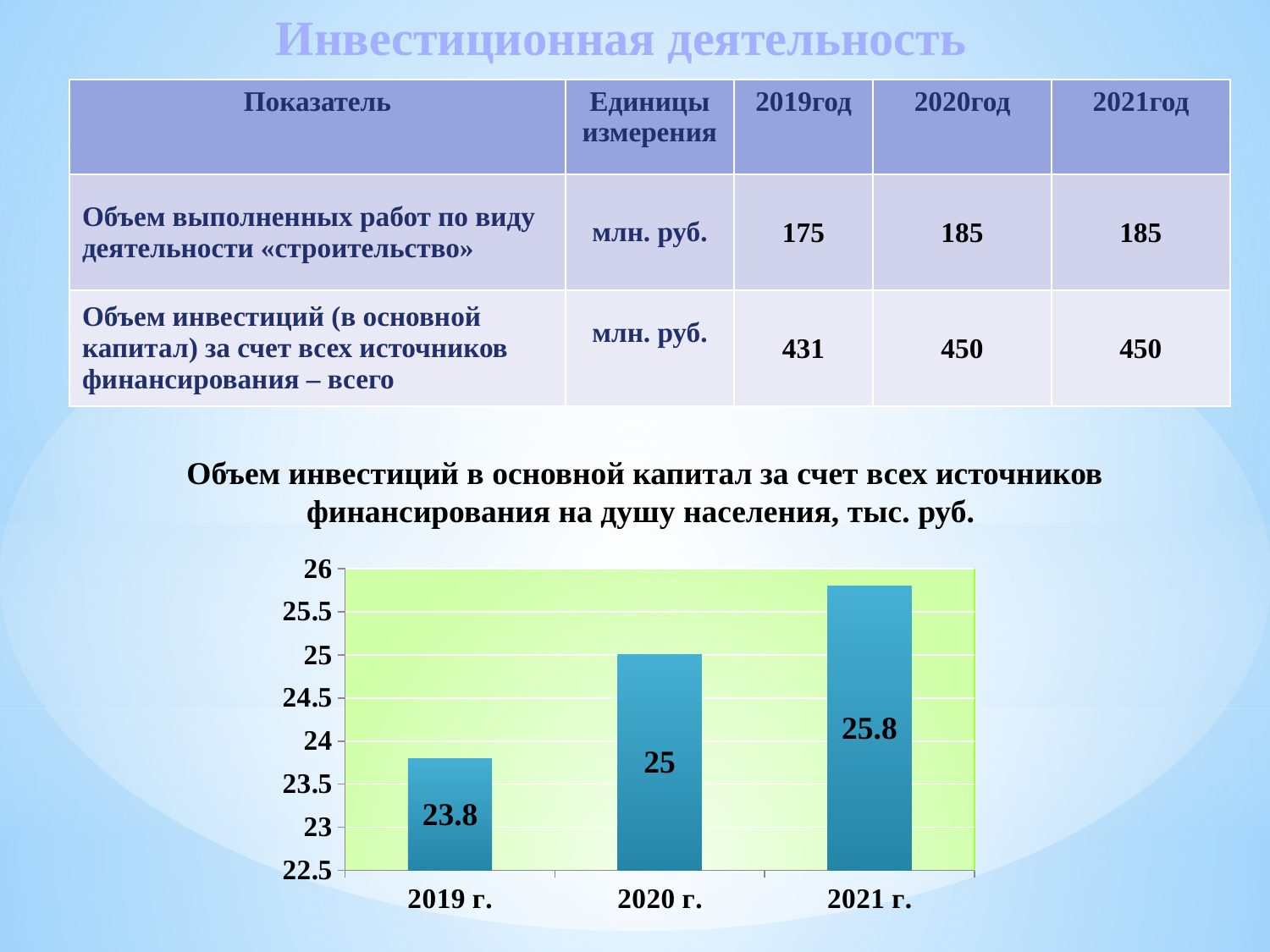
What is the value for 2020 г. in the chart? 25 Which is larger, the value for 2020 г. or the value for 2021 г.? 2021 г. What is the value for 2021 г. in the chart? 25.8 Is the value for 2019 г. greater or less than 24? less Do the values rise or fall from 2019 г. to 2021 г.? rise What kind of chart is shown on the slide? bar chart What is the difference between the values for 2020 г. and 2019 г.? 1.2 Which year has the highest value in the chart? 2021 г. What is the value for 2019 г. in the chart? 23.8 Which year has the lowest value in the chart? 2019 г. How many bars are shown in the chart? 3 What is the difference between the values for 2021 г. and 2019 г.? 2